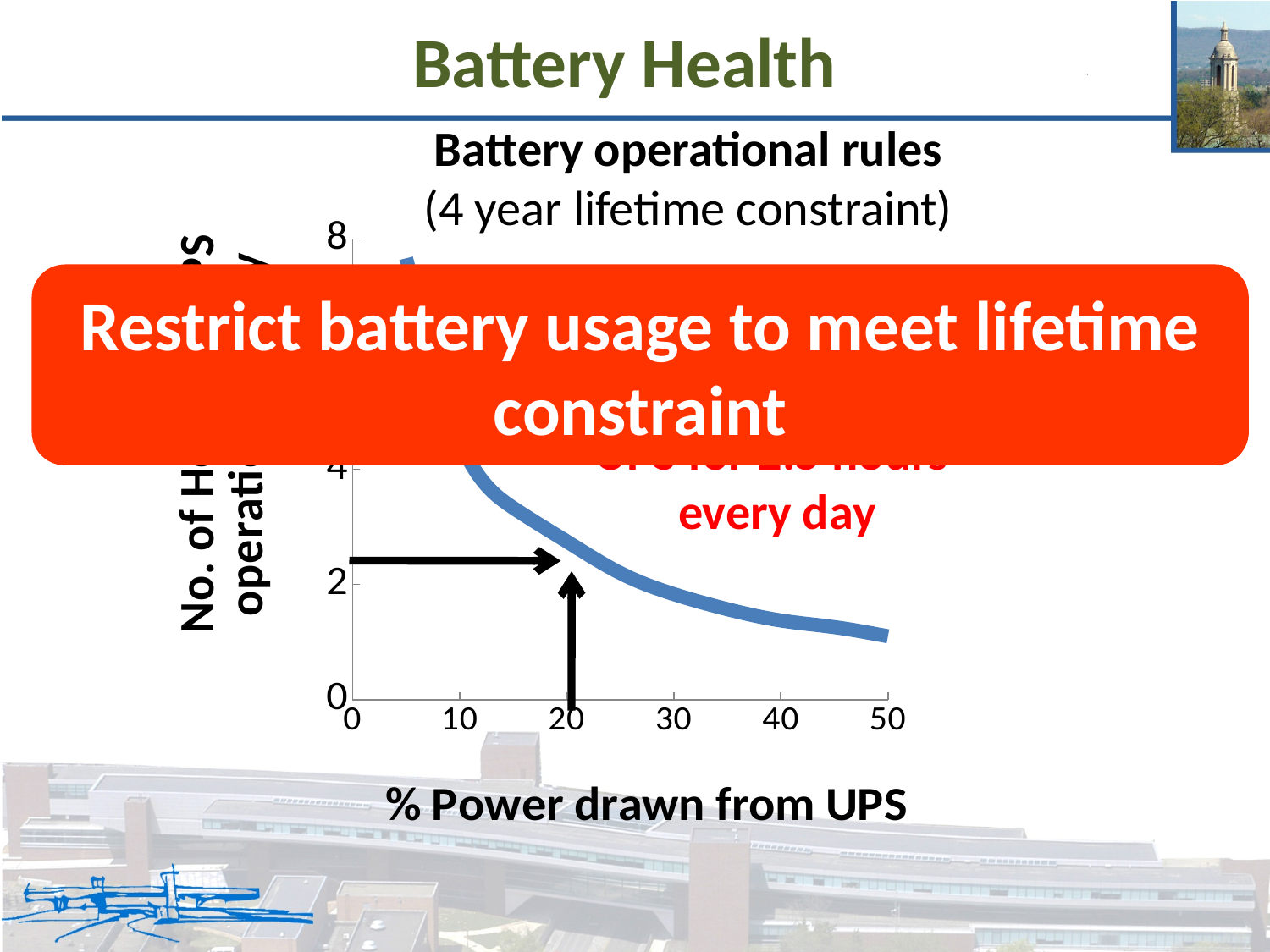
As the % Power drawn from UPS increases, does the plotted curve rise or fall? fall Is the value of the curve at 20% Power drawn from UPS greater or less than 2? greater Is the value of the curve at 40% Power drawn from UPS greater or less than 4? less What is the title of the chart? Battery operational rules (4 year lifetime constraint) What is the label of the x axis of the chart? % Power drawn from UPS Is the value of the curve at 40% Power drawn from UPS greater or less than 2? less How many lines are plotted on the chart? 1 What kind of chart is shown on the slide? line chart What is the highest tick value shown on the x axis? 50